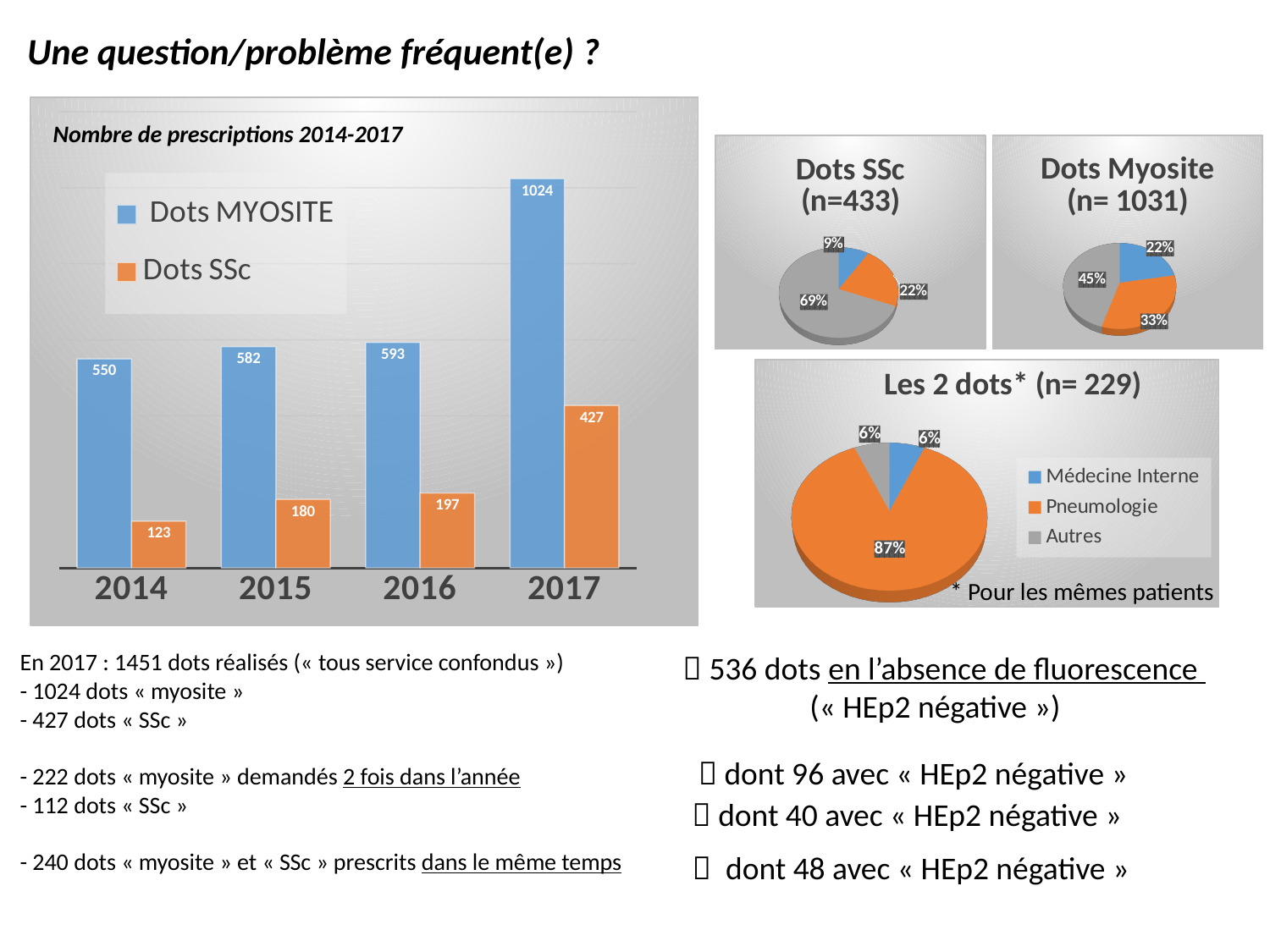
In the chart 'Nombre de prescriptions 2014-2017', do the Dots SSc values rise or fall from 2014 to 2017? rise In the pie chart 'Dots SSc (n=433)', what is the largest slice's percentage? 69% What kind of chart is 'Nombre de prescriptions 2014-2017'? bar chart In the chart 'Nombre de prescriptions 2014-2017', which year has the lowest value for Dots MYOSITE? 2014 In the chart 'Nombre de prescriptions 2014-2017', what is the value for Dots MYOSITE in 2017? 1024 In the chart 'Nombre de prescriptions 2014-2017', is the value for Dots MYOSITE in 2015 larger or smaller than the value for Dots SSc in 2017? larger In the chart 'Nombre de prescriptions 2014-2017', what is the value for Dots SSc in 2014? 123 In the pie chart 'Dots Myosite (n= 1031)', what is the smallest slice's percentage? 22% In the pie chart 'Les 2 dots* (n= 229)', what share does Pneumologie have? 87% In the chart 'Nombre de prescriptions 2014-2017', how many series does the legend list? 2 In the chart 'Nombre de prescriptions 2014-2017', what is the difference between Dots MYOSITE and Dots SSc in 2016? 396 In the chart 'Nombre de prescriptions 2014-2017', which year has the highest value for Dots SSc? 2017